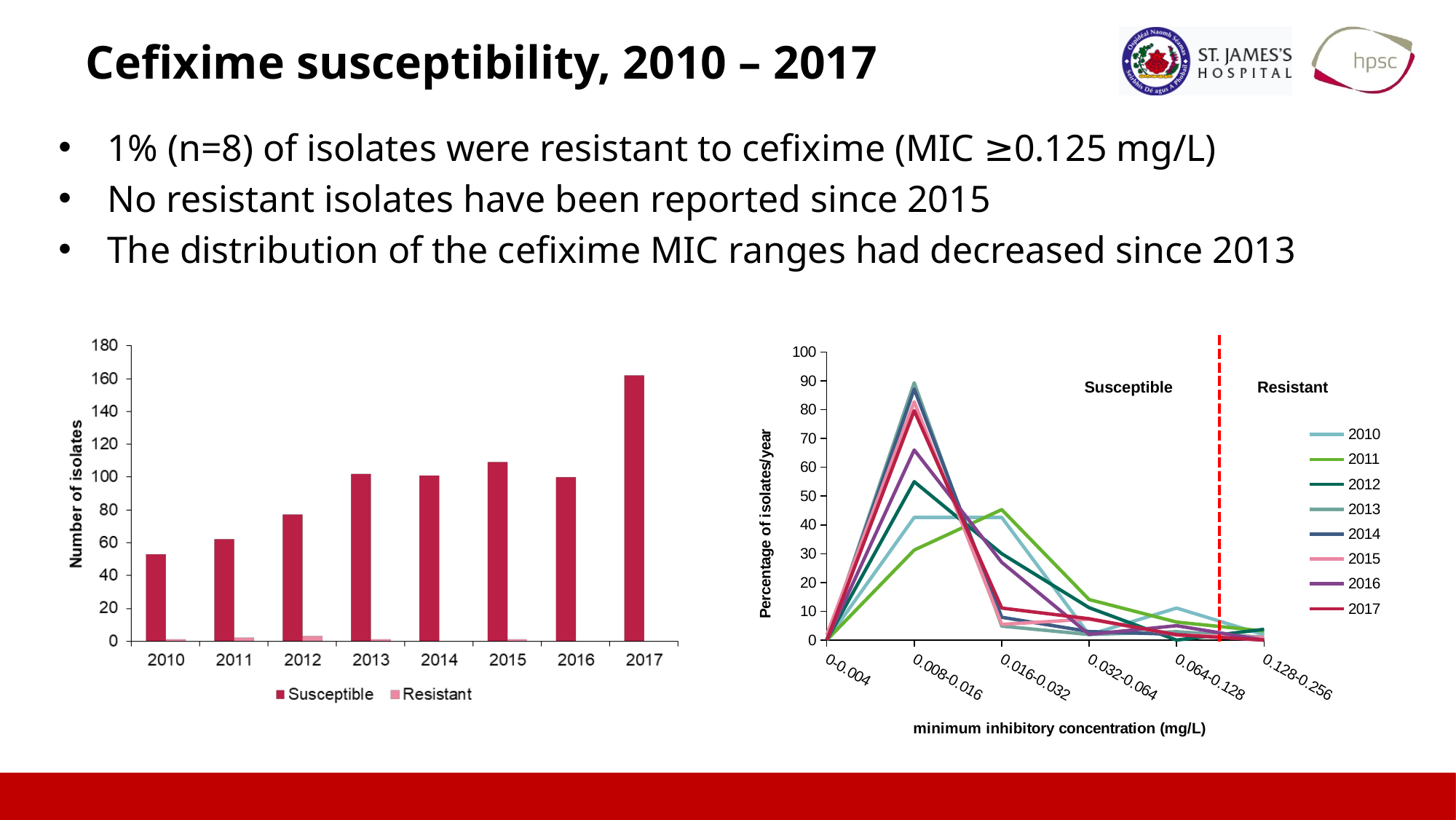
In the left bar chart, is the number of susceptible isolates in 2017 greater or less than 140? greater How many years are shown on the x axis of the left bar chart? 8 In the left bar chart, which year has the lowest number of susceptible isolates? 2010 In the left bar chart, is the number of susceptible isolates in 2010 greater or less than 60? less How many series does the legend of the right line chart list? 8 What kind of chart is the chart on the right of the slide? line chart How many series does the legend of the left bar chart list? 2 In the right line chart, is the value for 2011 at the 0.008-0.016 MIC range greater or less than 40? less What is the x-axis label of the right line chart? minimum inhibitory concentration (mg/L) What kind of chart is the chart on the left of the slide? bar chart In the left bar chart, which year has the highest number of susceptible isolates? 2017